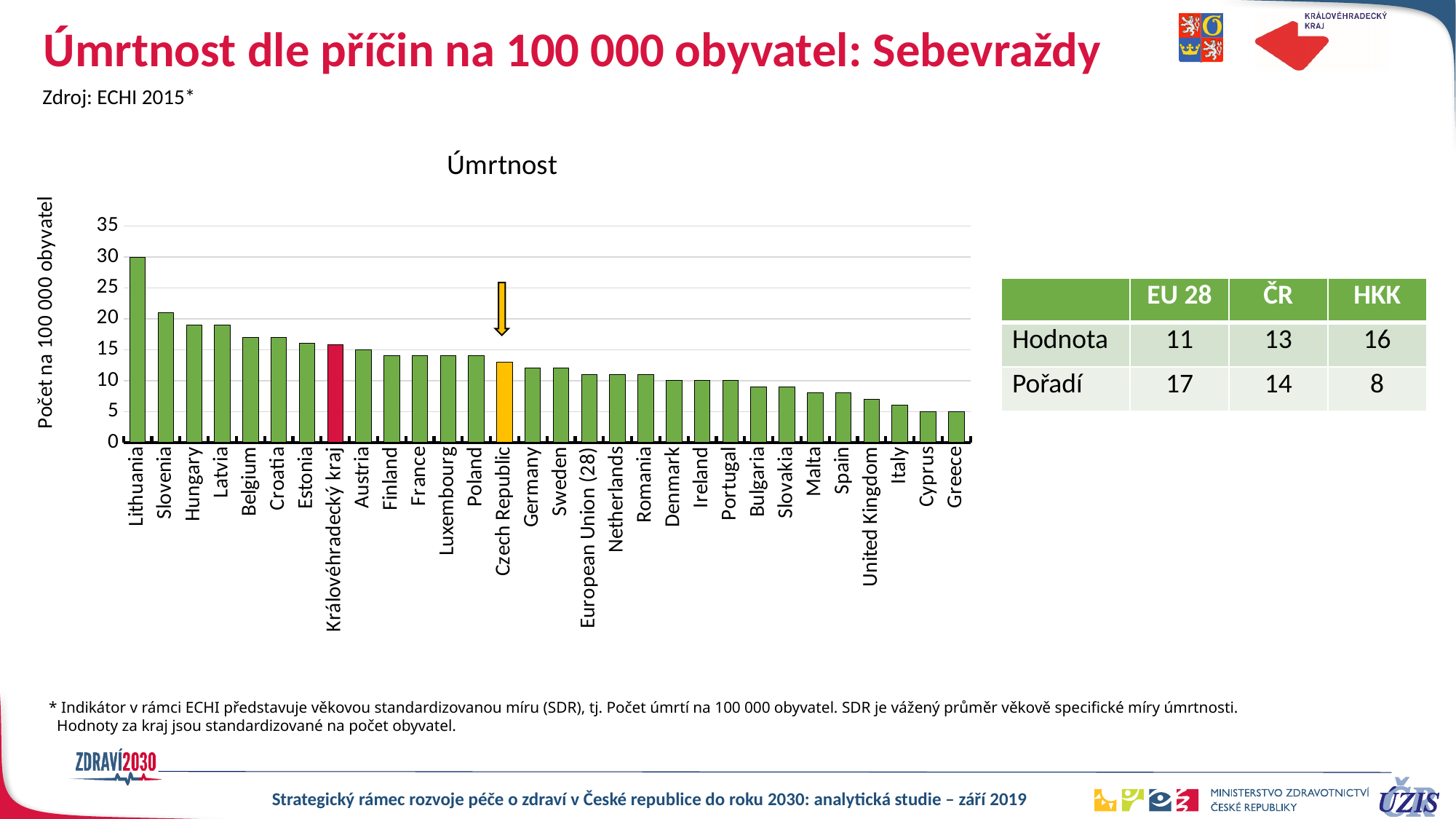
What is the value for Královéhradecký kraj (HKK), as given in the table on the slide? 16 Which country has the highest value in the chart? Lithuania Do the values rise or fall from left to right along the x axis? fall What kind of chart is shown on the slide? bar chart Is the value for Lithuania greater or less than 25? greater What is the difference between the value for HKK and the value for ČR shown in the table? 3 Is the value for Hungary greater or less than 20? less What is the value for Czech Republic, as given in the table on the slide? 13 What is the title of the chart? Úmrtnost Which is larger, the value for Lithuania or the value for Slovenia? Lithuania How many categories (bars) are plotted in the chart? 30 Is the value for Greece greater or less than 10? less